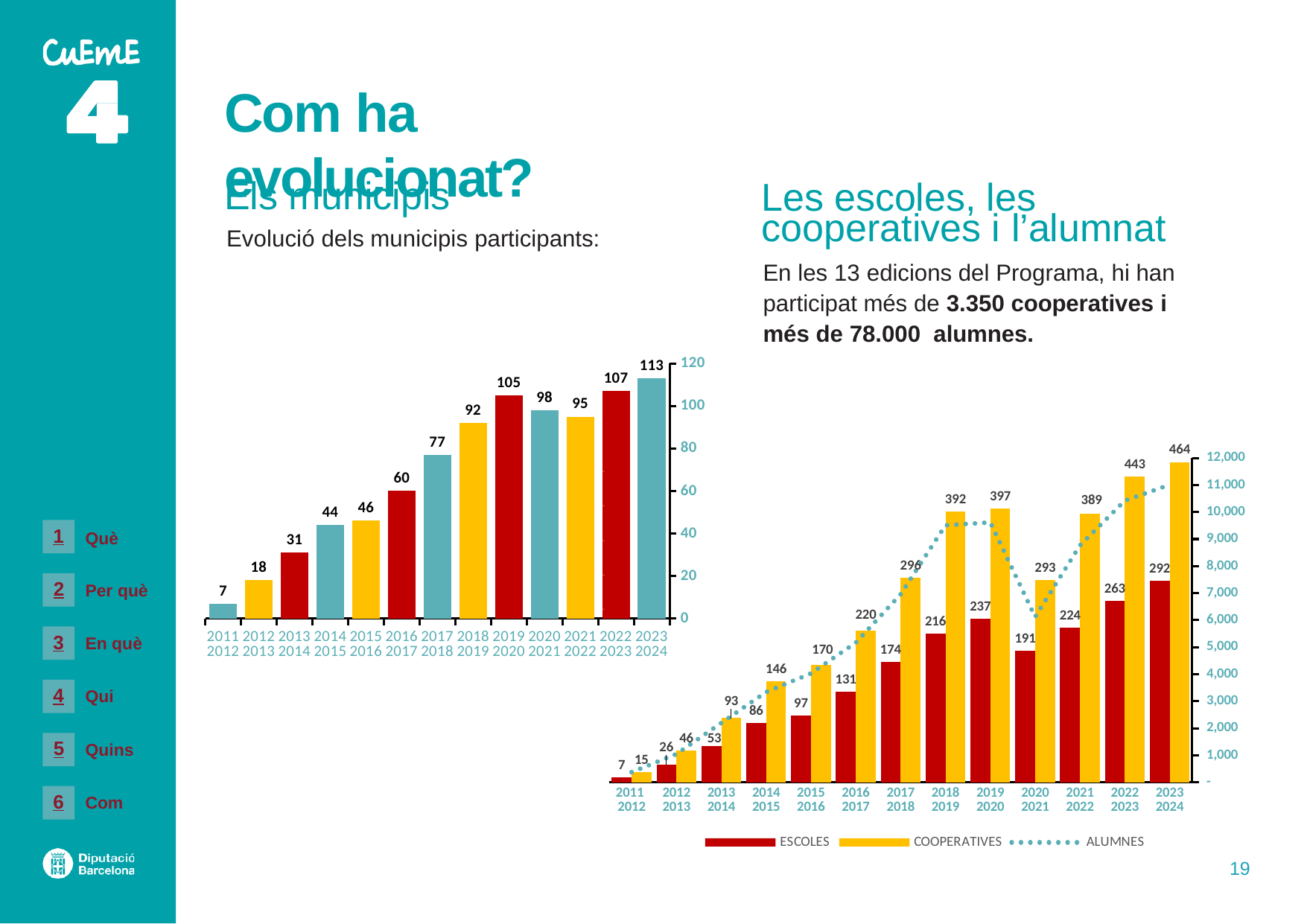
In the right chart (Les escoles, les cooperatives i l'alumnat), which series is drawn as a dotted line? ALUMNES In the right chart (Les escoles, les cooperatives i l'alumnat), what is the difference between the COOPERATIVES and ESCOLES values for 2018-2019? 176 In the right chart (Les escoles, les cooperatives i l'alumnat), how many series does the legend list? 3 In the left chart (Els municipis), what is the difference between the 2019-2020 value and the 2020-2021 value? 7 In the left chart (Els municipis), how many participating municipalities are shown for 2023-2024? 113 In the right chart (Les escoles, les cooperatives i l'alumnat), which edition has the highest COOPERATIVES value? 2023 2024 In the left chart (Els municipis), how many editions (bars) are plotted? 13 In the left chart (Els municipis), which edition has the lowest value? 2011 2012 In the right chart (Les escoles, les cooperatives i l'alumnat), is the ALUMNES value for 2023-2024 greater or less than 10,000? greater In the left chart (Els municipis), what is the value for 2017-2018? 77 In the right chart (Les escoles, les cooperatives i l'alumnat), what is the ESCOLES value for 2020-2021? 191 In the right chart (Les escoles, les cooperatives i l'alumnat), what is the COOPERATIVES value for 2023-2024? 464